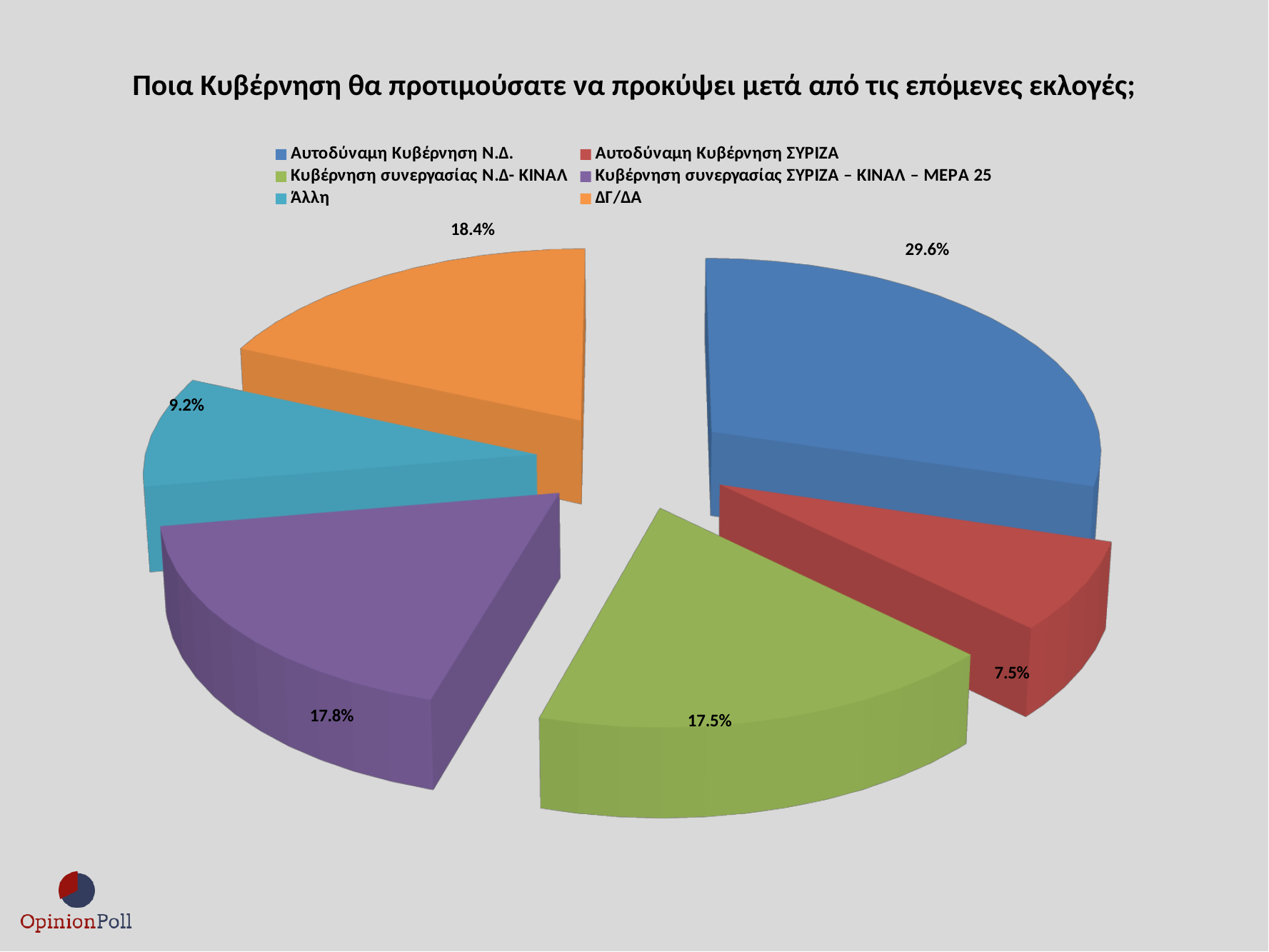
What kind of chart is shown on the slide? Pie chart Which is larger, the slice for ΔΓ/ΔΑ or the slice for Άλλη? ΔΓ/ΔΑ How many slices does the pie chart have? 6 Which category has the largest slice of the pie? Αυτοδύναμη Κυβέρνηση Ν.Δ. What percentage is shown for Κυβέρνηση συνεργασίας Ν.Δ- ΚΙΝΑΛ? 17.5% What percentage is shown for Αυτοδύναμη Κυβέρνηση Ν.Δ.? 29.6% What percentage is shown for ΔΓ/ΔΑ? 18.4% Which category has the smallest slice of the pie? Αυτοδύναμη Κυβέρνηση ΣΥΡΙΖΑ What is the difference in percentage points between Αυτοδύναμη Κυβέρνηση Ν.Δ. and Αυτοδύναμη Κυβέρνηση ΣΥΡΙΖΑ? 22.1 What percentage is shown for Αυτοδύναμη Κυβέρνηση ΣΥΡΙΖΑ? 7.5% What percentage is shown for Κυβέρνηση συνεργασίας ΣΥΡΙΖΑ – ΚΙΝΑΛ – ΜΕΡΑ 25? 17.8% What colour is the slice for Άλλη? Light blue